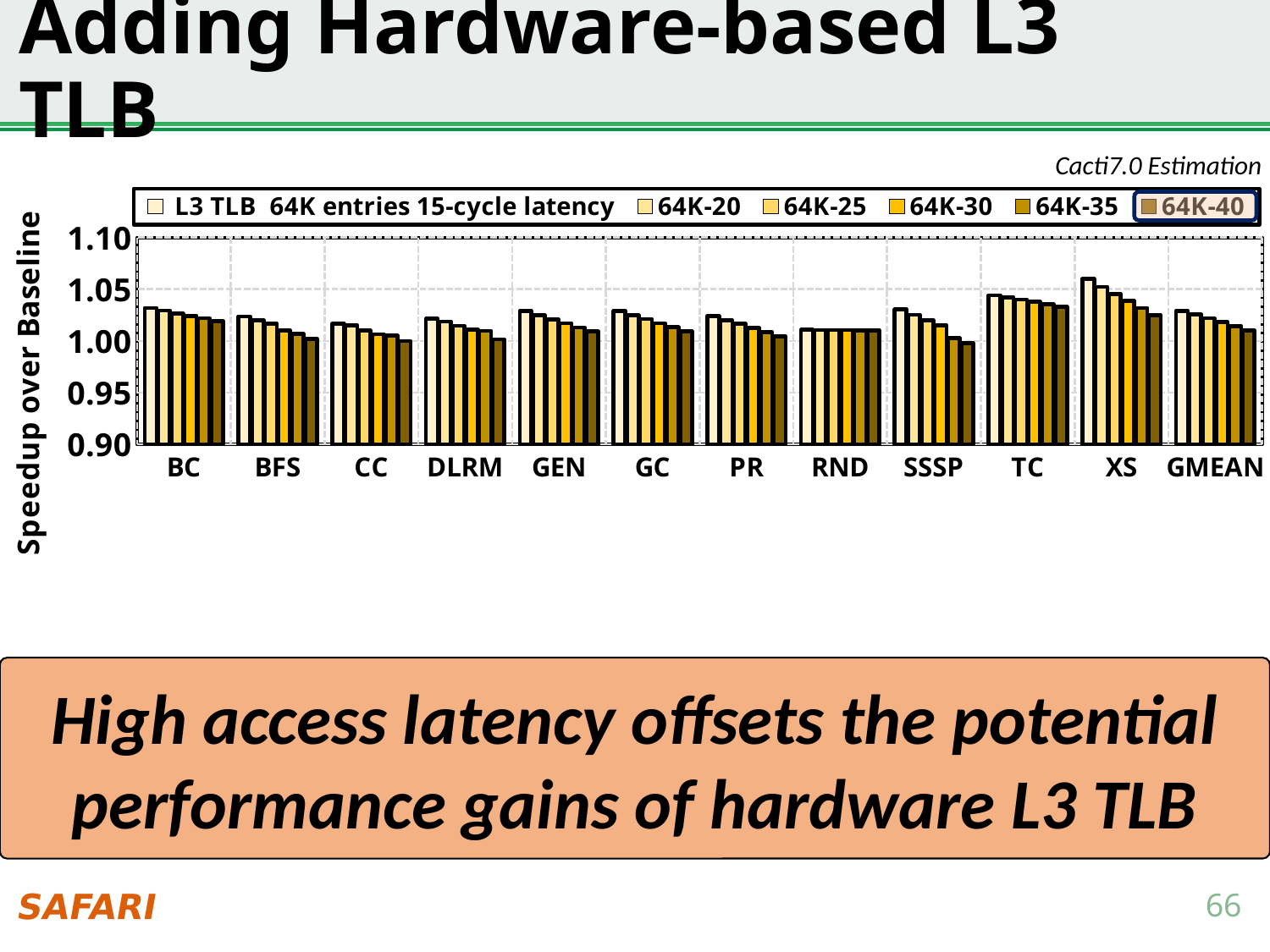
Is the value of the 64K-40 bar for SSSP greater or less than 1.05? less What kind of chart is shown on the slide? bar chart How many series does the chart's legend list? 6 Which is larger for XS: the first (15-cycle latency) bar or the 64K-40 bar? the first (15-cycle latency) bar How many categories are shown along the x axis of the chart? 12 Is the value of the first (L3 TLB 64K entries 15-cycle latency) bar for BC greater or less than 1.05? less Which category has the tallest bar in the chart? XS Which legend entry is highlighted with a box in the chart's legend? 64K-40 Within each category, do the bars rise or fall as the series move from the 15-cycle latency to 64K-40? fall Is the value of the 64K-40 bar for CC greater or less than 0.95? greater What is the label of the chart's y axis? Speedup over Baseline